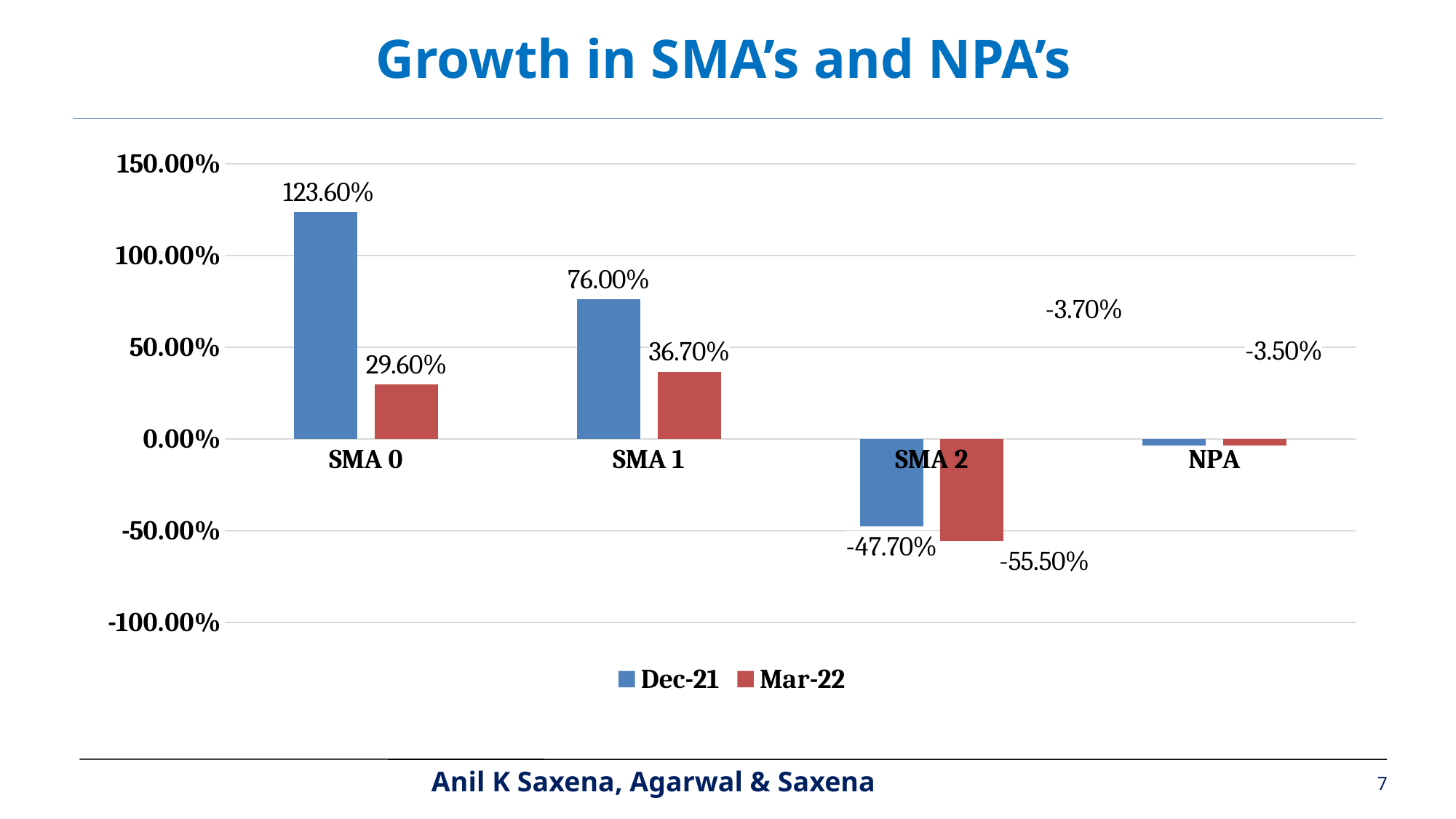
What is the Dec-21 value for SMA 0? 123.60% What is the Dec-21 value for NPA? -3.70% How many series does the legend list? 2 Which category has the lowest Mar-22 value? SMA 2 Which category has the highest Dec-21 value? SMA 0 What is the Mar-22 value for SMA 1? 36.70% What is the difference between the Dec-21 and Mar-22 values for SMA 0? 94.00% What kind of chart is shown on the slide? Bar chart Which is larger for SMA 1: the Dec-21 value or the Mar-22 value? Dec-21 What is the Mar-22 value for SMA 2? -55.50% How many categories are shown on the x axis? 4 What is the title of the chart? Growth in SMA's and NPA's